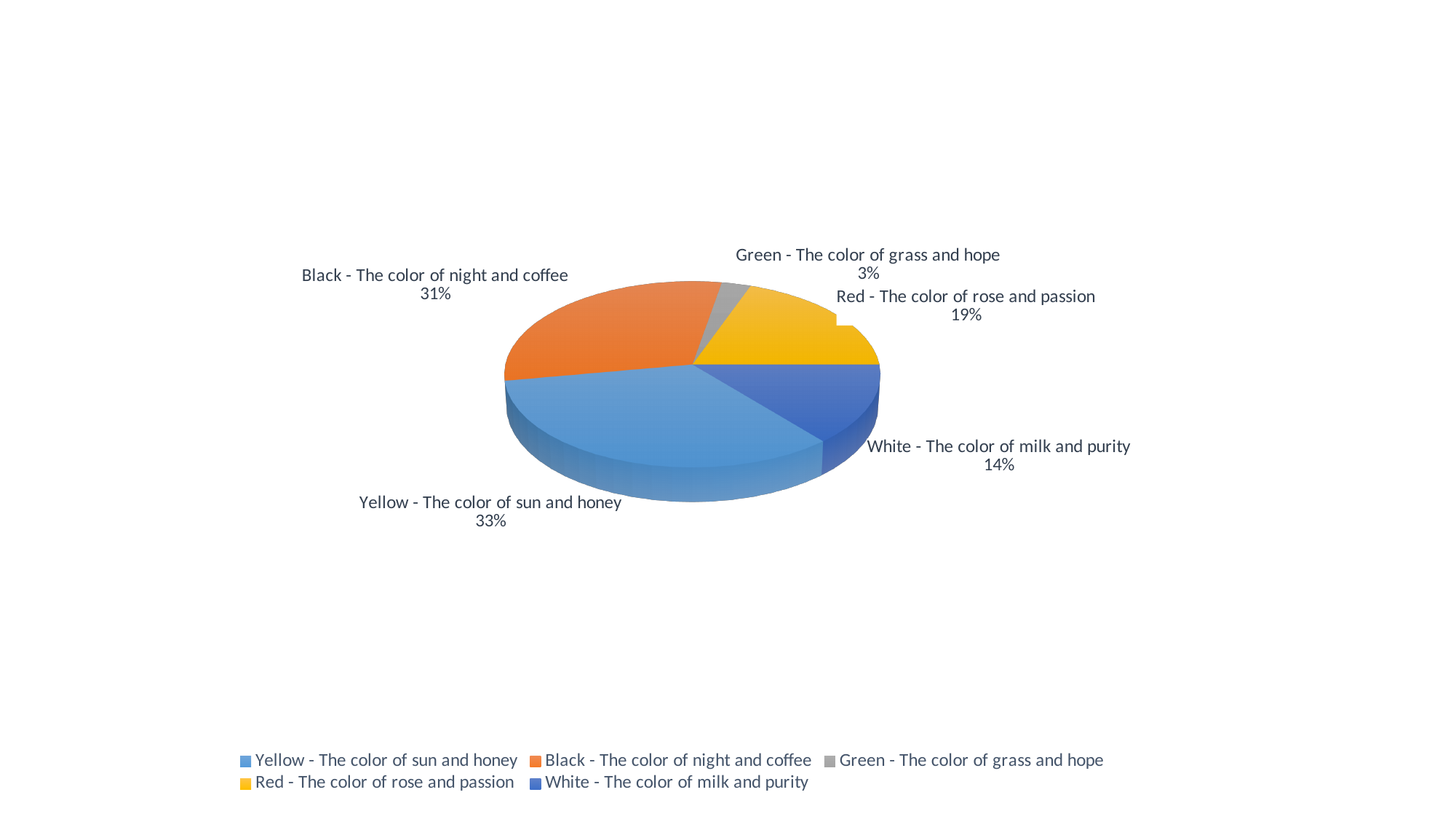
What share of the pie does "Yellow - The color of sun and honey" have? 33% What percentage is shown for "Red - The color of rose and passion"? 19% How many slices does the pie chart have? 5 What percentage is shown for "White - The color of milk and purity"? 14% What percentage is shown for "Green - The color of grass and hope"? 3% What share of the pie does "Black - The color of night and coffee" have? 31% Which slice of the pie is the smallest? Green - The color of grass and hope What kind of chart is shown on the slide? Pie chart What is the difference in percentage points between the Red slice and the White slice? 5 What colour is the slice for "Green - The color of grass and hope" drawn in? Grey Which slice of the pie is the largest? Yellow - The color of sun and honey Which is larger, the Black slice or the Red slice? Black - The color of night and coffee